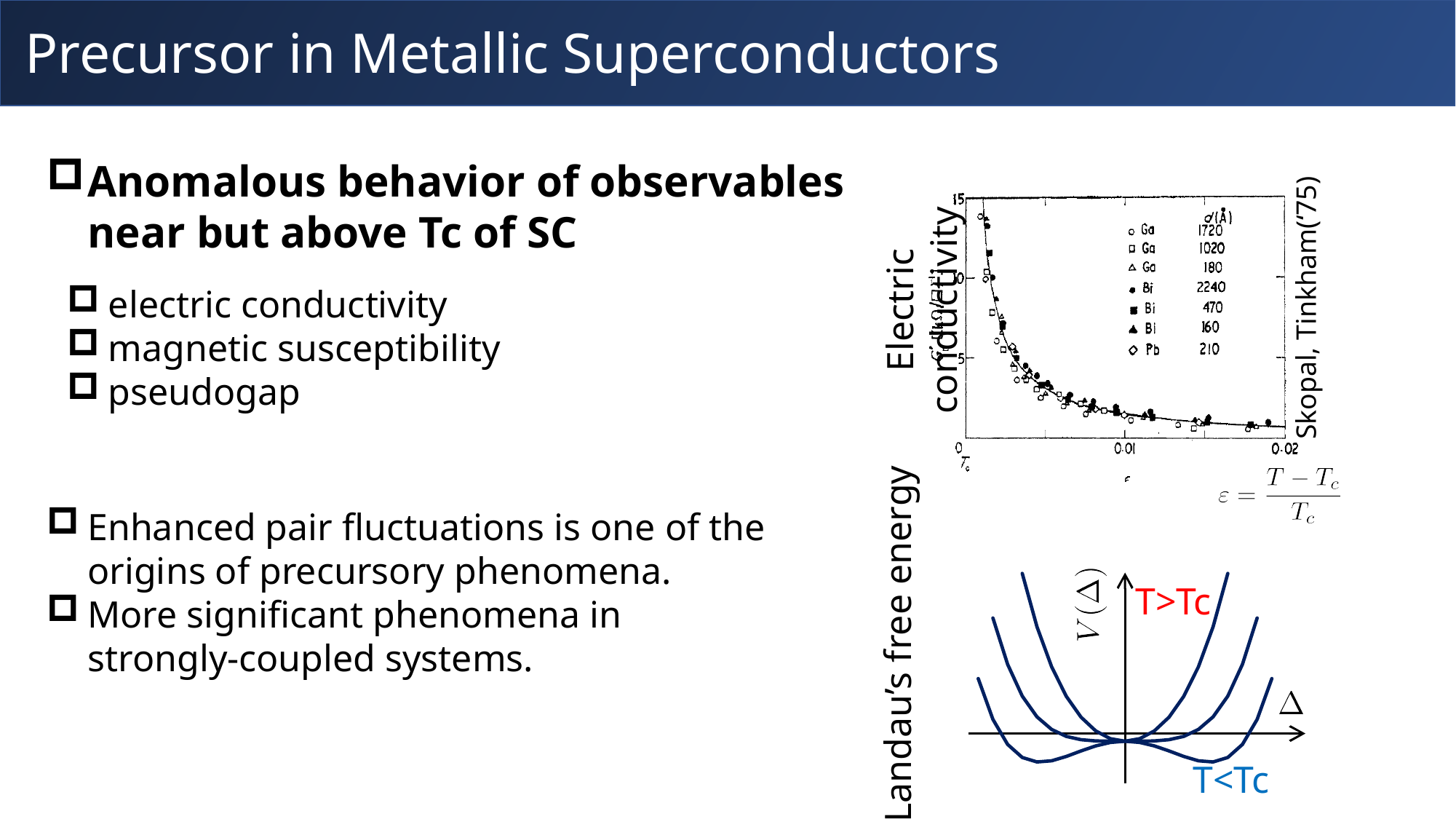
In the Landau's free energy chart (bottom right), how many curves are drawn? 3 In the electric conductivity chart (top right), do the values rise or fall as ε increases along the x axis? fall In the electric conductivity chart (top right), is the plotted value at ε = 0.01 greater or less than 5? less In the Landau's free energy chart (bottom right), which label is written in blue? T<Tc In the electric conductivity chart (top right), what is the smallest d(Å) value listed in the legend? 160 In the Landau's free energy chart (bottom right), what kind of chart is it? line chart In the electric conductivity chart (top right), what is the largest d(Å) value listed in the legend? 2240 In the electric conductivity chart (top right), what is the highest tick value shown on the x axis? 0.02 In the electric conductivity chart (top right), what kind of chart is it? scatter plot In the electric conductivity chart (top right), is the plotted value at ε = 0.02 greater or less than 5? less In the electric conductivity chart (top right), how many series does the legend list? 7 In the electric conductivity chart (top right), what is the d(Å) value listed for Pb in the legend? 210